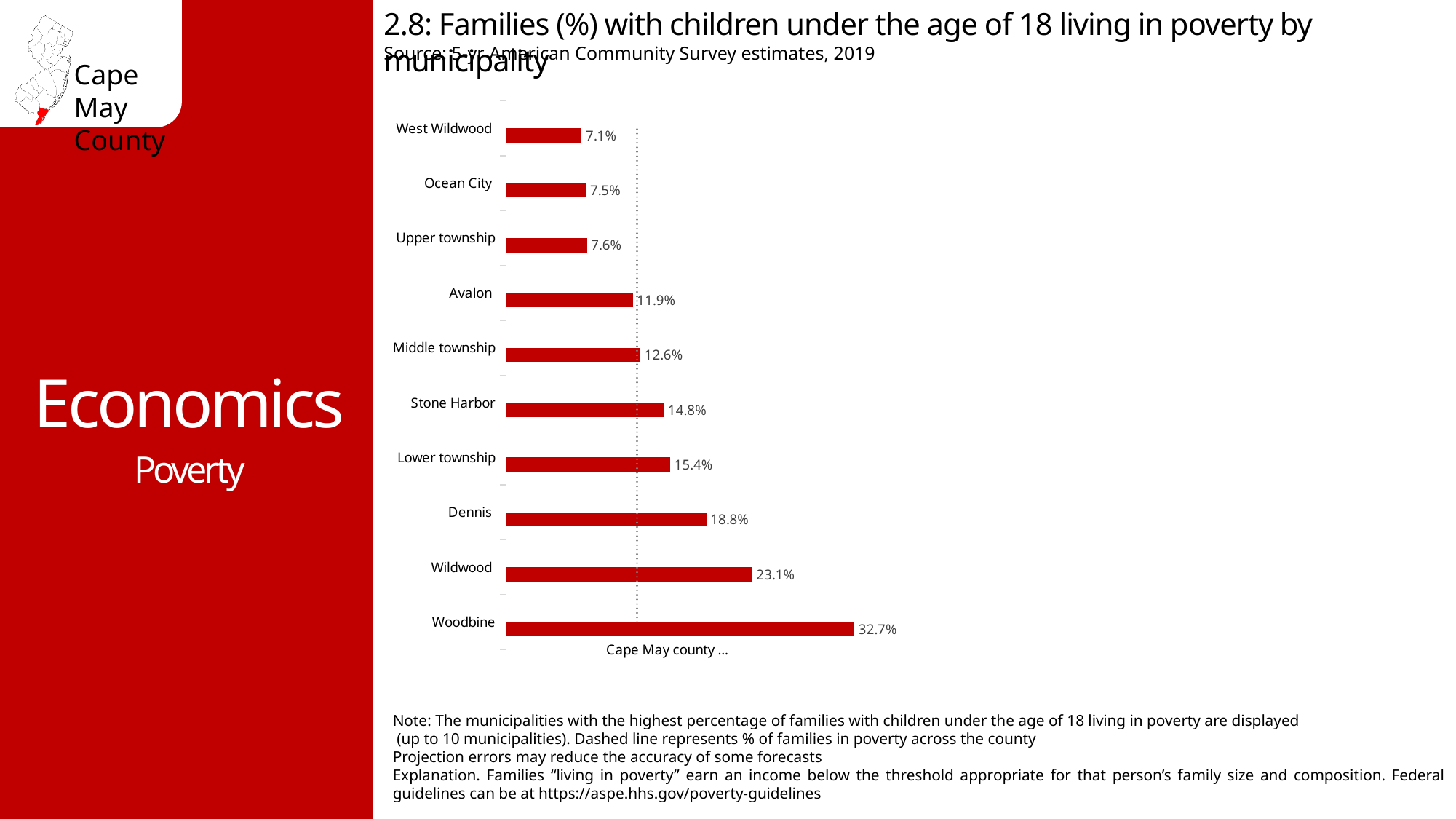
How many municipalities are shown on the chart? 10 What does the dashed vertical line on the chart represent? % of families in poverty across Cape May county Which municipality has the lowest value shown on the chart? West Wildwood Which has a larger value, Avalon or Dennis? Dennis What is the difference between the values for Wildwood and Dennis? 4.3% What is the value for Woodbine? 32.7% Which municipality has the highest percentage of families with children under 18 living in poverty? Woodbine What is the value for Ocean City? 7.5% What is the value for Middle township? 12.6% Which has a larger value, Stone Harbor or Lower township? Lower township What kind of chart is shown on the slide? Bar chart What is the difference between the values for Woodbine and West Wildwood? 25.6%